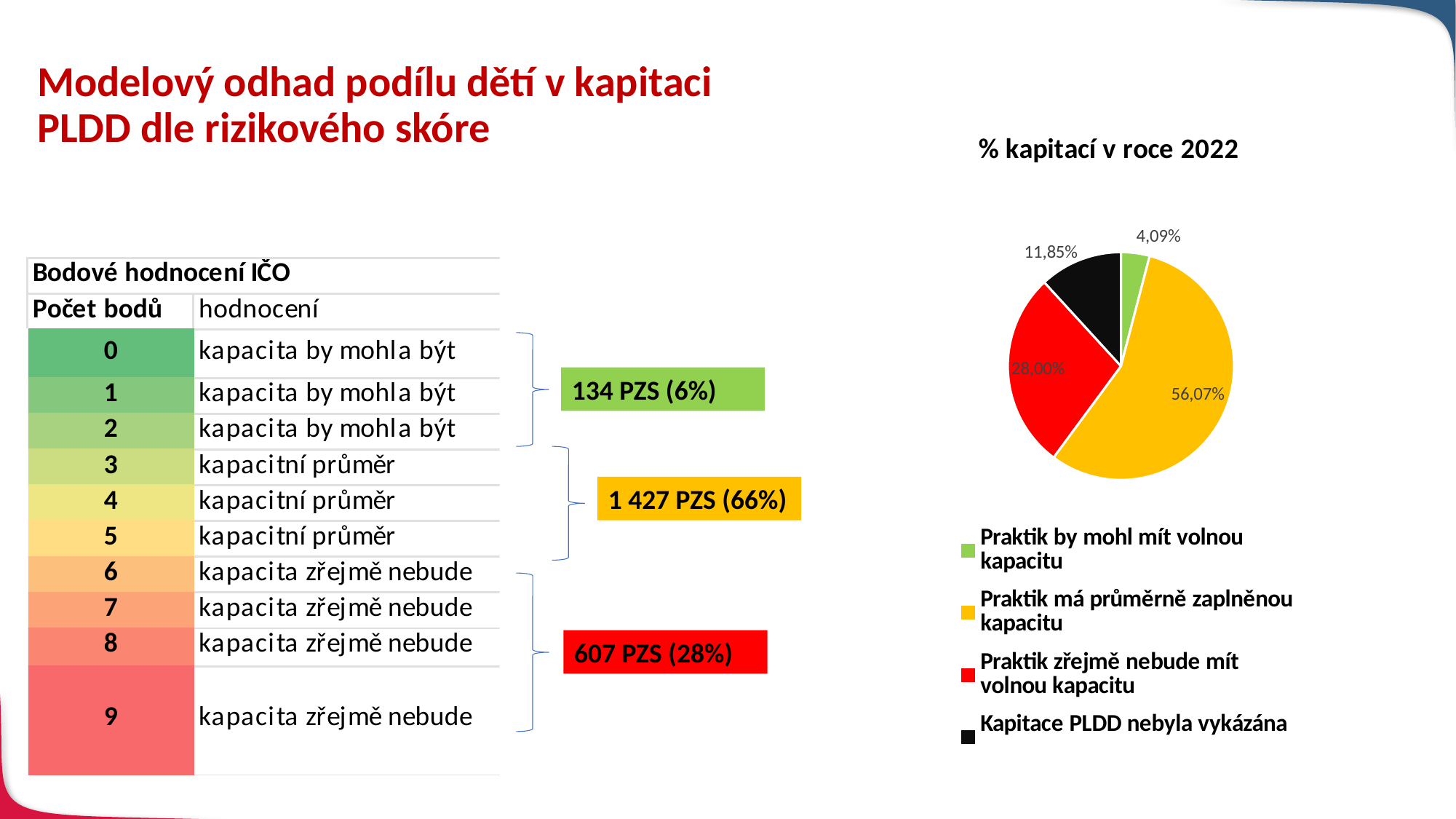
Which colour represents "Kapitace PLDD nebyla vykázána" in the pie chart? black What is the value for "Praktik zřejmě nebude mít volnou kapacitu"? 28,00% What is the title of the chart? % kapitací v roce 2022 How many slices does the pie chart have? 4 How many entries does the chart legend list? 4 What is the difference between the values for "Praktik zřejmě nebude mít volnou kapacitu" and "Kapitace PLDD nebyla vykázána"? 16,15% Which category has the largest slice of the pie? Praktik má průměrně zaplněnou kapacitu What is the value for "Praktik by mohl mít volnou kapacitu"? 4,09% What is the value for "Kapitace PLDD nebyla vykázána"? 11,85% What is the value for "Praktik má průměrně zaplněnou kapacitu"? 56,07% What type of chart is shown on the slide? pie chart Which category has the smallest slice of the pie? Praktik by mohl mít volnou kapacitu